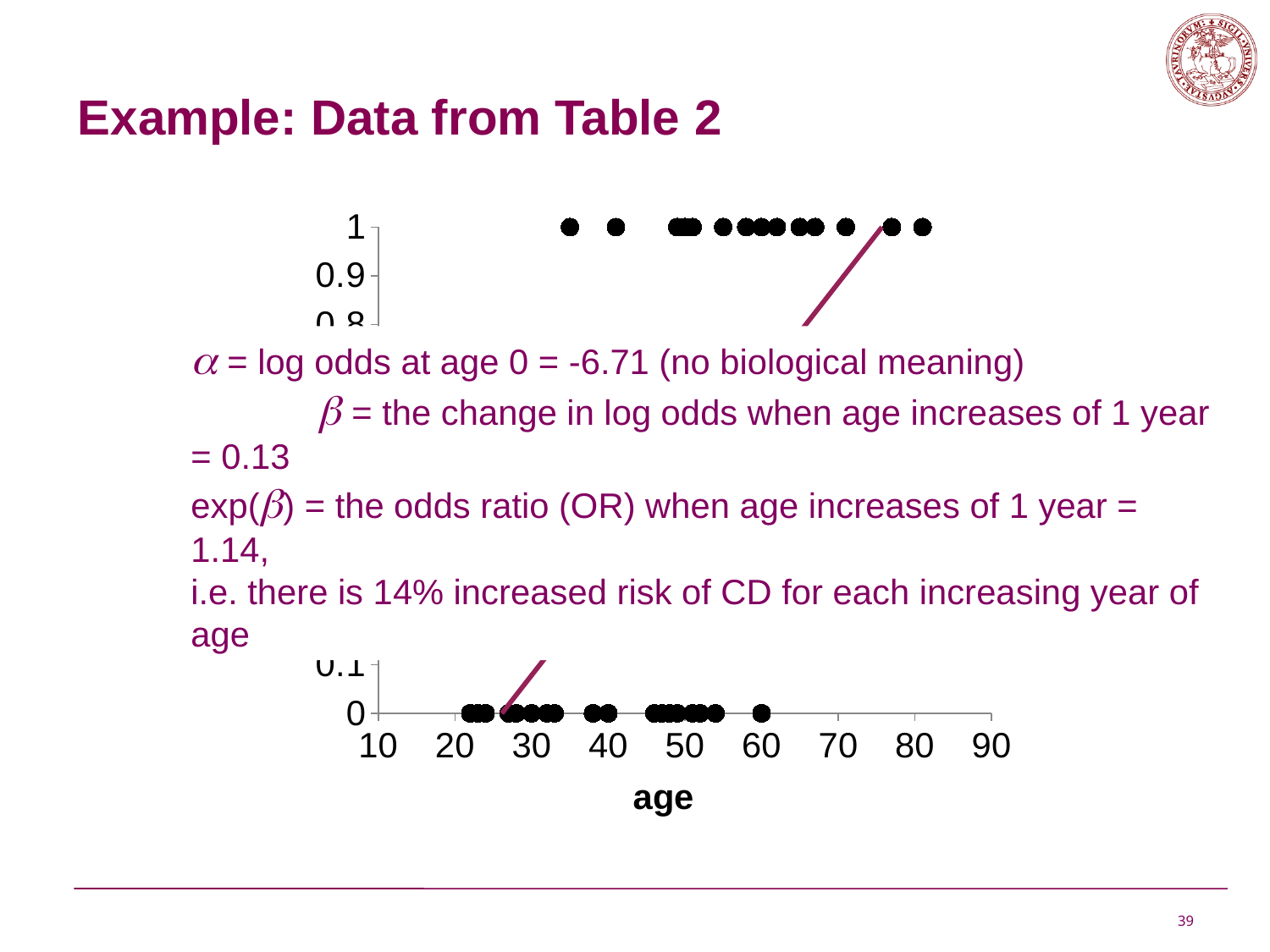
Is the age of the leftmost point plotted at y = 1 greater or less than 30? greater What is the spacing between consecutive tick marks on the x axis of the chart? 10 Are the points plotted at y = 1 generally at older or younger ages than the points plotted at y = 0? older What is the highest tick value shown on the y axis of the chart? 1 What kind of chart is shown on the slide? scatter chart What is the label of the x axis of the chart? age What is the lowest tick value shown on the x axis of the chart? 10 Is the age of the leftmost point plotted at y = 0 greater or less than 30? less What is the highest tick value shown on the x axis of the chart? 90 Is the age of the rightmost point plotted at y = 0 greater or less than 70? less Does the fitted curve in the chart rise or fall as age increases? rise